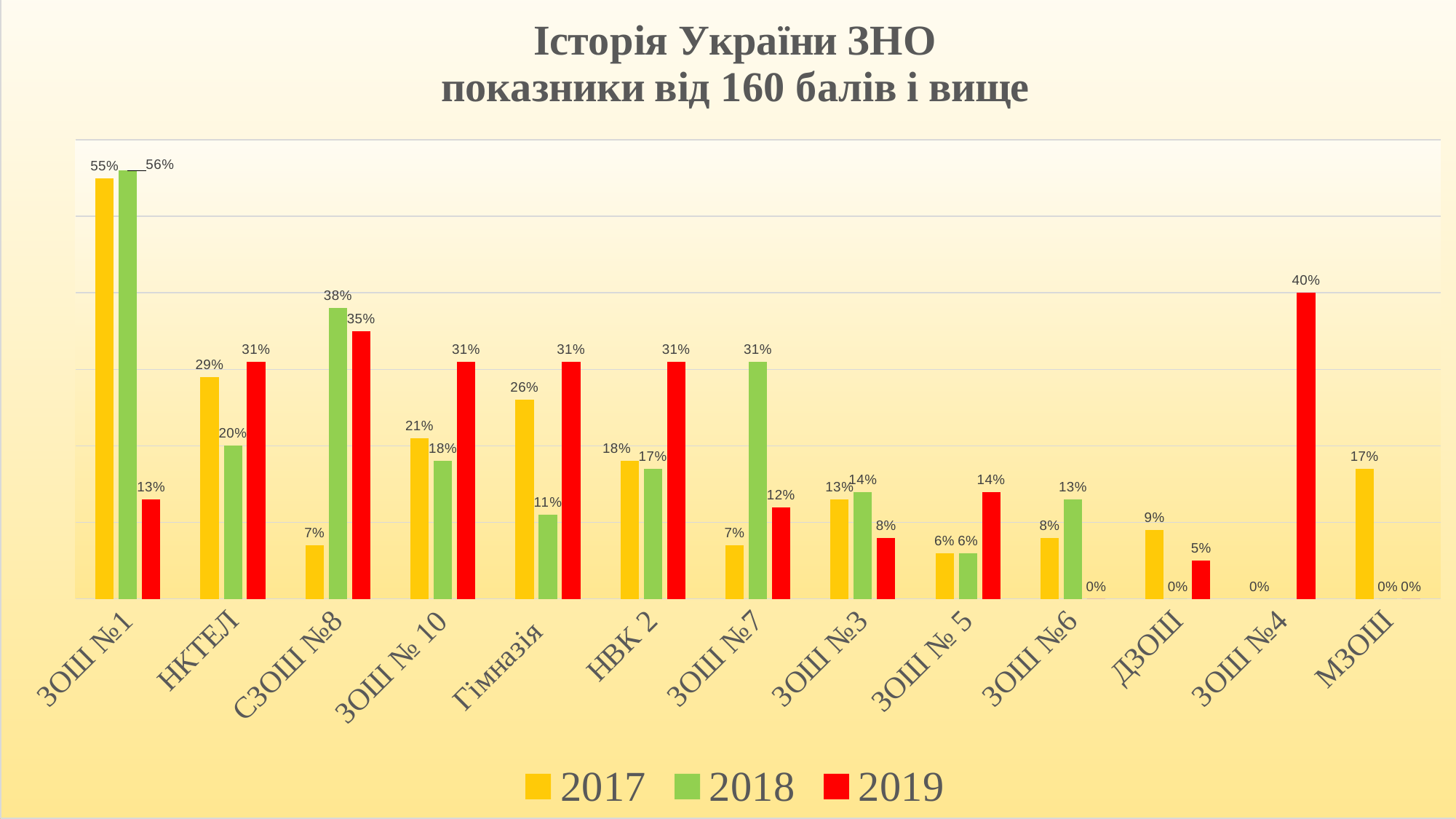
How many schools are shown on the x axis? 13 What is the 2019 value for СЗОШ №8? 35% What is the difference between the 2018 and 2017 values for СЗОШ №8? 31% What is the 2018 value for ЗОШ №7? 31% Which school has the highest 2018 value? ЗОШ №1 Which school has the highest 2019 value? ЗОШ №4 Which colour represents the 2019 series in the legend? Red How many series does the legend list? 3 Which is larger for НКТЕЛ, the 2017 value or the 2018 value? 2017 What kind of chart is shown on the slide? Bar chart What is the difference between the 2019 and 2017 values for ЗОШ №1? 42% What is the 2017 value for Гімназія? 26%